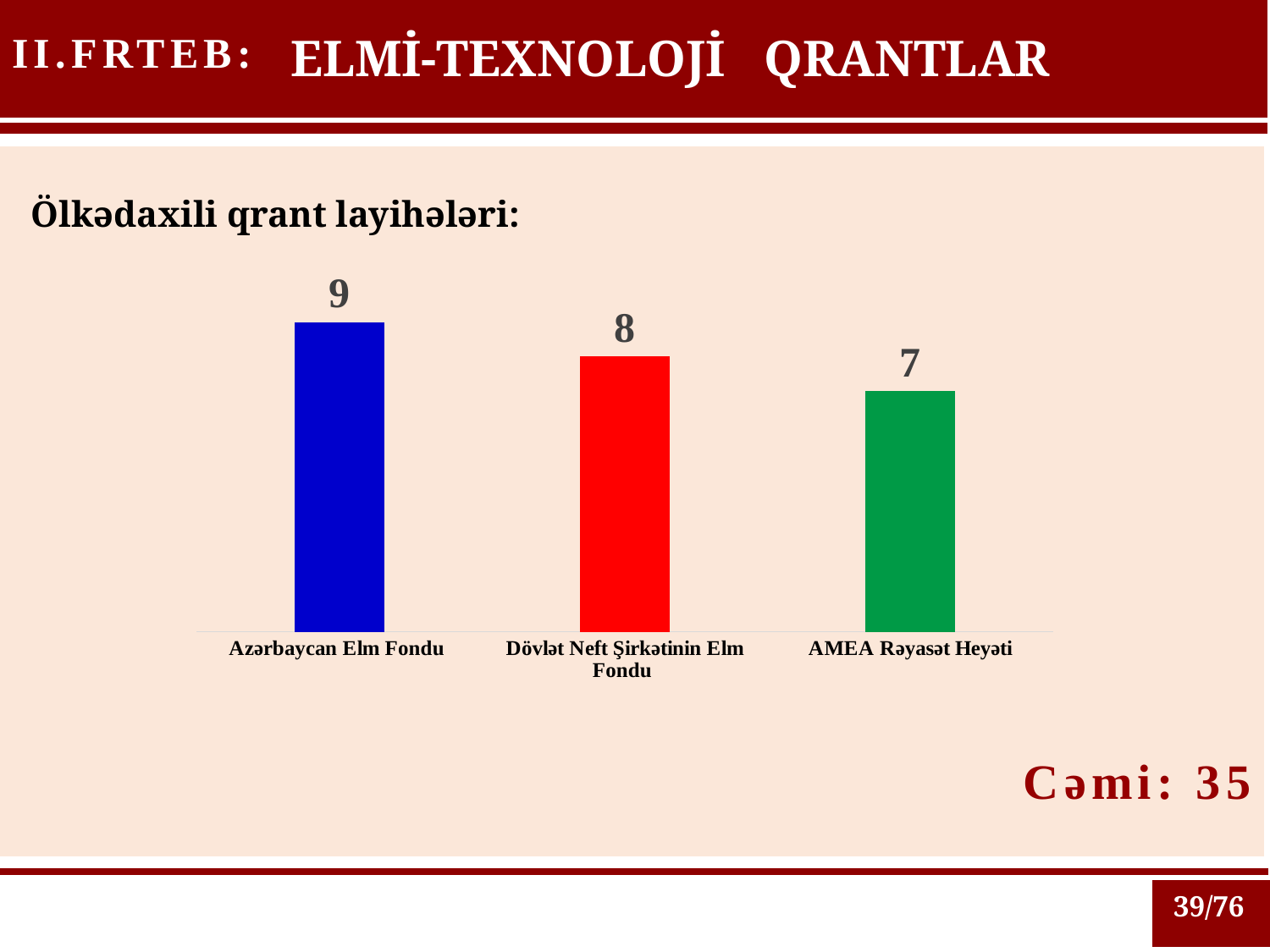
What is the value for Dövlət Neft Şirkətinin Elm Fondu? 8 What is the difference between the values for Dövlət Neft Şirkətinin Elm Fondu and AMEA Rəyasət Heyəti? 1 What is the value for Azərbaycan Elm Fondu? 9 What is the difference between the values for Azərbaycan Elm Fondu and AMEA Rəyasət Heyəti? 2 Do the values rise or fall from left to right across the categories? fall What colour is the bar for Dövlət Neft Şirkətinin Elm Fondu? red What is the value for AMEA Rəyasət Heyəti? 7 Which category has the highest value? Azərbaycan Elm Fondu Which category has the lowest value? AMEA Rəyasət Heyəti What kind of chart is shown on the slide? bar chart Which is larger, the value for Azərbaycan Elm Fondu or the value for Dövlət Neft Şirkətinin Elm Fondu? Azərbaycan Elm Fondu How many categories are shown in the chart? 3